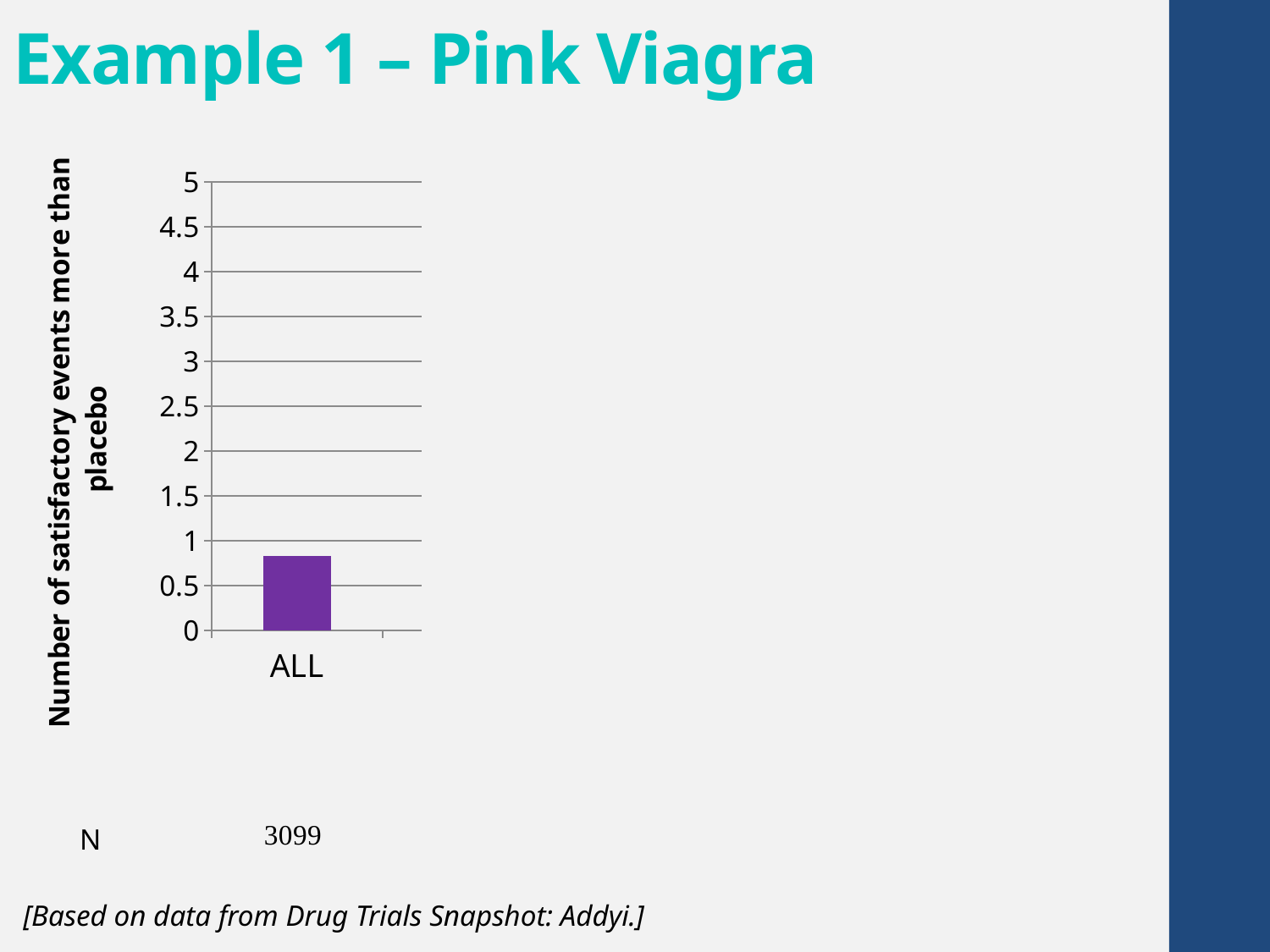
How many bars does the chart show? 1 What is the y-axis title of the chart? Number of satisfactory events more than placebo Is the value for ALL greater or less than 1? less What kind of chart is shown on the slide? bar chart What is the highest value shown on the y axis? 5 Is the value for ALL greater or less than 0.5? greater What is the label of the only category on the x axis? ALL Is the value for ALL greater or less than 2? less